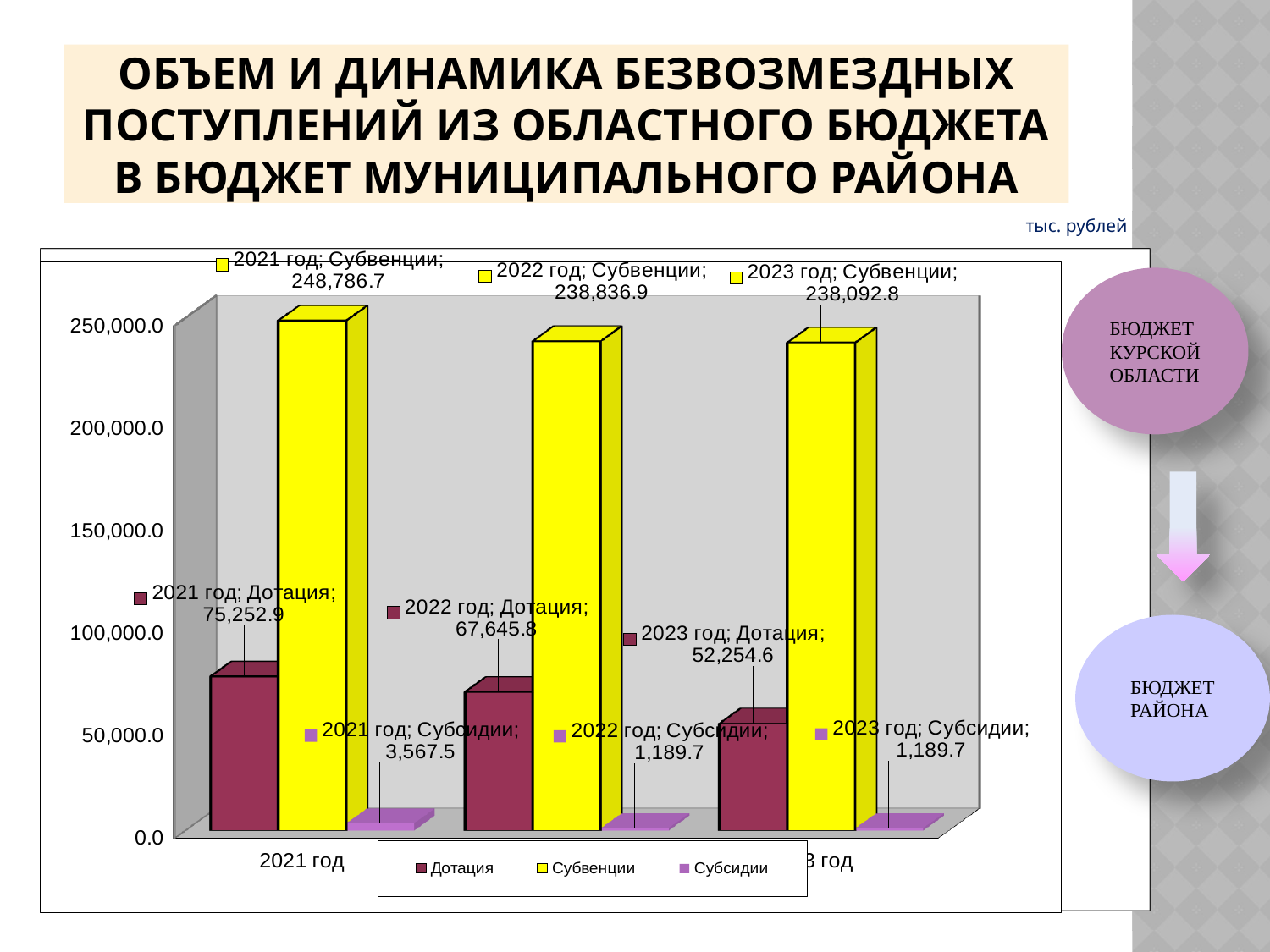
Is the value of Дотация for 2021 год greater or less than 50,000.0? greater What is the value of Субсидии for 2022 год? 1,189.7 In which year is Дотация the highest? 2021 год How many series does the legend list? 3 Does Дотация rise or fall from 2021 год to 2023 год? fall What is the difference between Дотация in 2021 год and 2023 год? 22,998.3 What is the value of Дотация for 2023 год? 52,254.6 What kind of chart is shown on the slide? bar chart What is the difference between Субвенции in 2021 год and 2022 год? 9,949.8 In which year is Субвенции the lowest? 2023 год What is the value of Субвенции for 2021 год? 248,786.7 Which is larger: Дотация in 2022 год or Дотация in 2023 год? Дотация in 2022 год